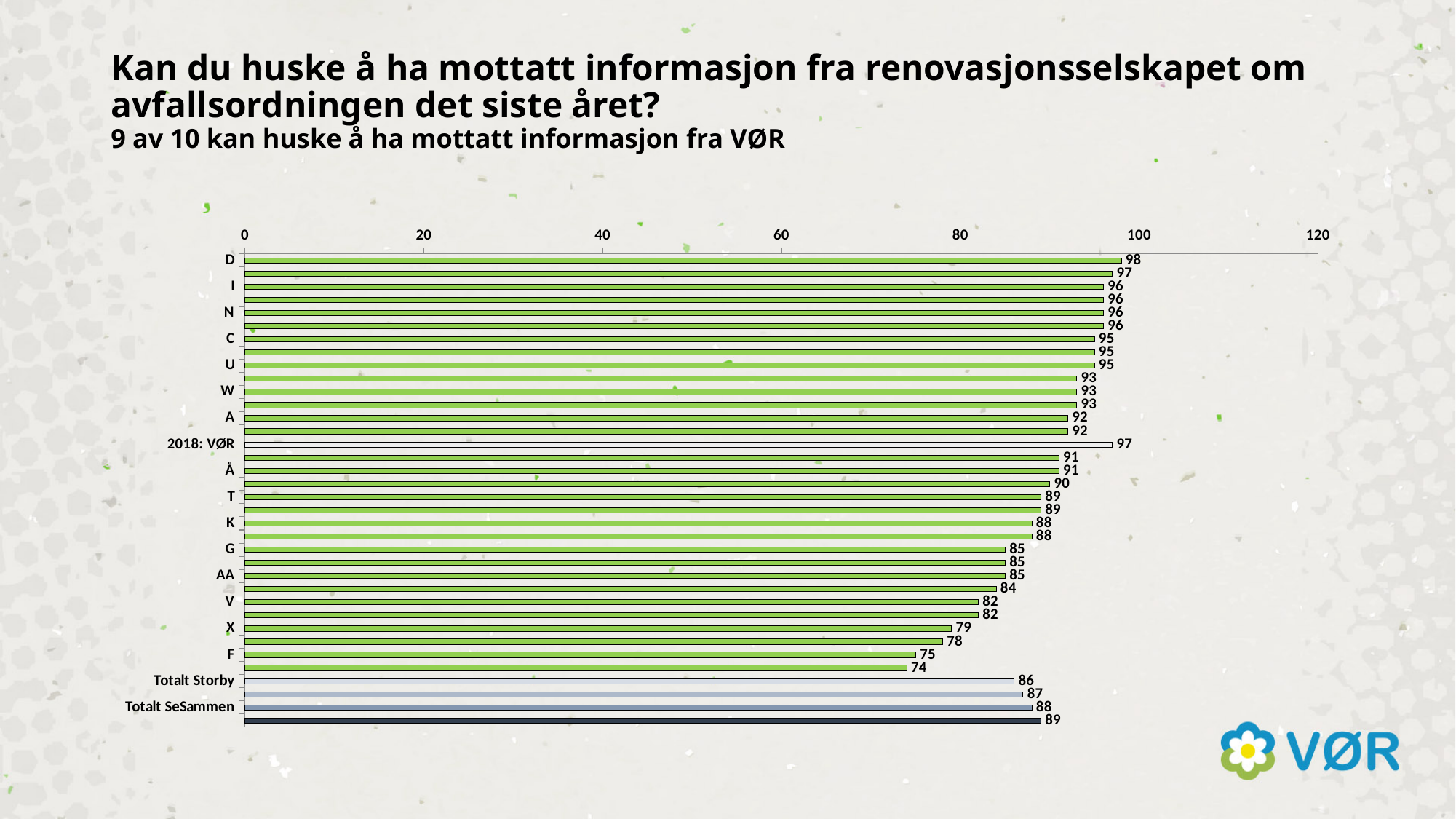
What is the subtitle shown under the chart title? 9 av 10 kan huske å ha mottatt informasjon fra VØR What kind of chart is shown on the slide? bar chart What is the value for Totalt SeSammen? 88 What is the difference between the values for D and F? 23 Which is larger, the value for K or the value for V? K What is the value for D? 98 Is the value for X greater or less than 80? less What is the value for Totalt Storby? 86 What is the value for 2018: VØR? 97 Which category has the highest value? D What is the value for X? 79 What is the value for F? 75